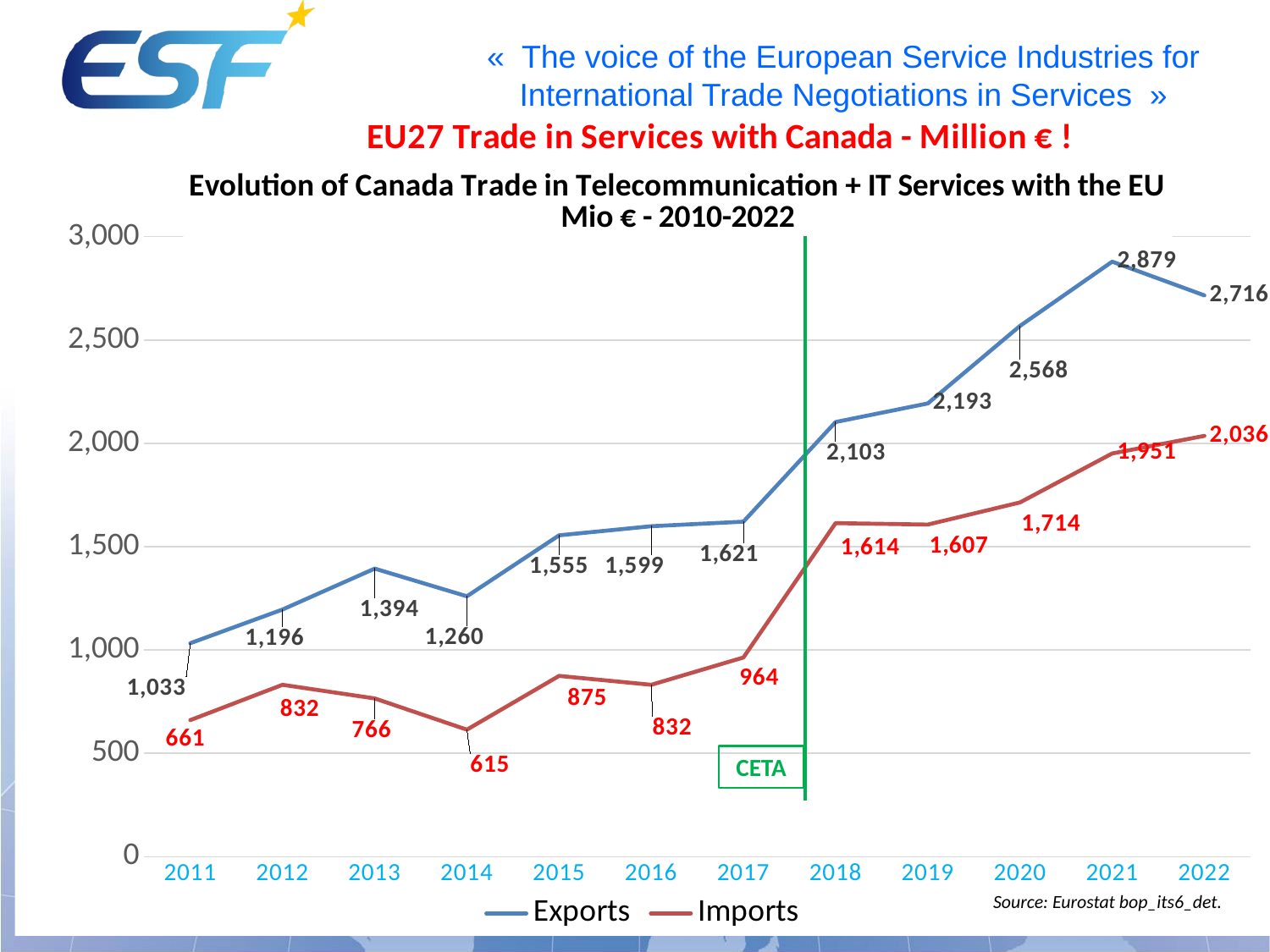
What is the difference between Exports and Imports in 2022? 680 In which year are Imports lowest? 2014 How many series does the legend list? 2 What is the value of Exports in 2018? 2,103 What label is shown in the green box next to the vertical green line? CETA Do Exports rise or fall from 2021 to 2022? Fall In which year are Exports highest? 2021 Which is larger, Imports in 2017 or Imports in 2015? Imports in 2017 What is the difference between Exports in 2021 and Exports in 2011? 1,846 How many years are shown on the x axis? 12 What is the value of Imports in 2014? 615 What kind of chart is shown on the slide? Line chart